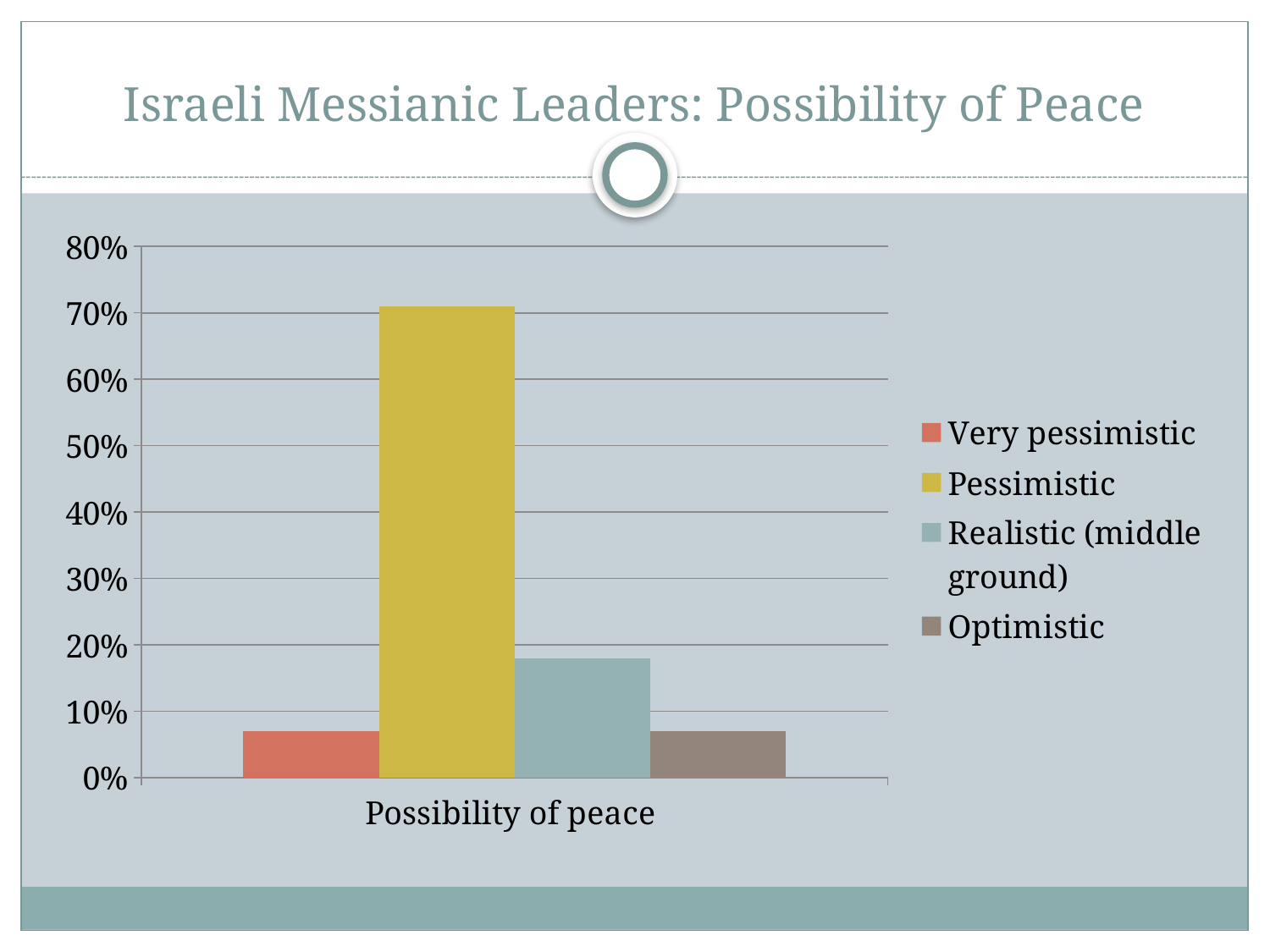
How many series does the legend list? 4 What is the category label shown on the x axis? Possibility of peace Is the value for Realistic (middle ground) greater or less than 10%? greater Which series has the highest value? Pessimistic What kind of chart is shown on the slide? bar chart Is the value for Very pessimistic greater or less than 10%? less Which is larger, the value for Pessimistic or the value for Realistic (middle ground)? Pessimistic Is the value for Optimistic greater or less than 10%? less Which is larger, the value for Realistic (middle ground) or the value for Optimistic? Realistic (middle ground) What is the title of the slide? Israeli Messianic Leaders: Possibility of Peace